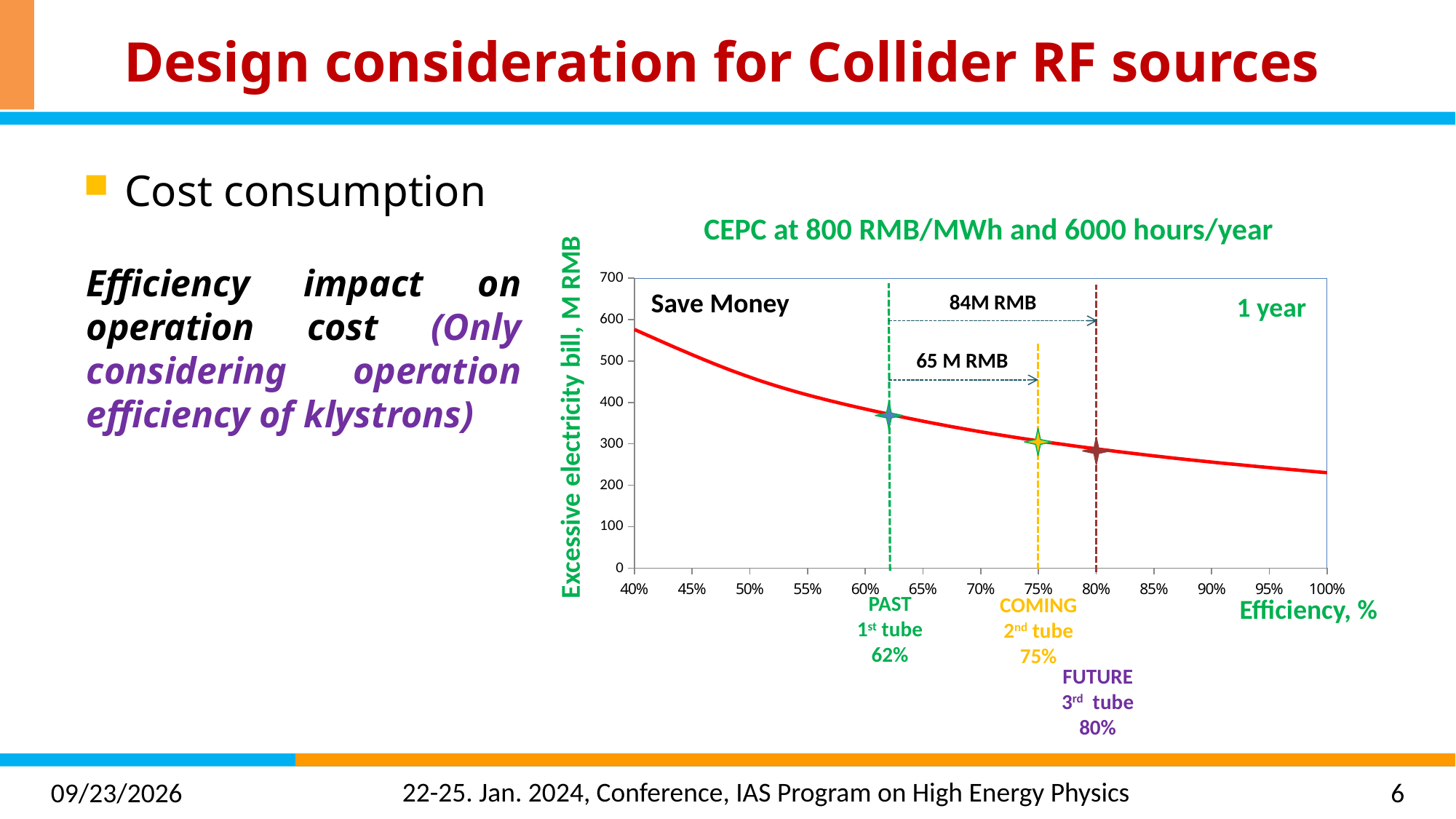
Does the excessive electricity bill rise or fall as efficiency increases along the x axis? fall What efficiency is marked for the FUTURE 3rd tube? 80% What efficiency is marked for the COMING 2nd tube? 75% Is the excessive electricity bill at 100% efficiency greater or less than 300? less How much money is saved per year by going from 62% to 80% efficiency, according to the annotation? 84M RMB What kind of chart is shown on the slide? line chart What efficiency is marked for the PAST 1st tube? 62% How much money is saved per year by going from 62% to 75% efficiency, according to the annotation? 65 M RMB What is the title of the chart? CEPC at 800 RMB/MWh and 6000 hours/year Is the excessive electricity bill at 62% efficiency greater or less than 300? greater Is the excessive electricity bill at 40% efficiency greater or less than 500? greater Which has the larger excessive electricity bill, 62% efficiency or 80% efficiency? 62%